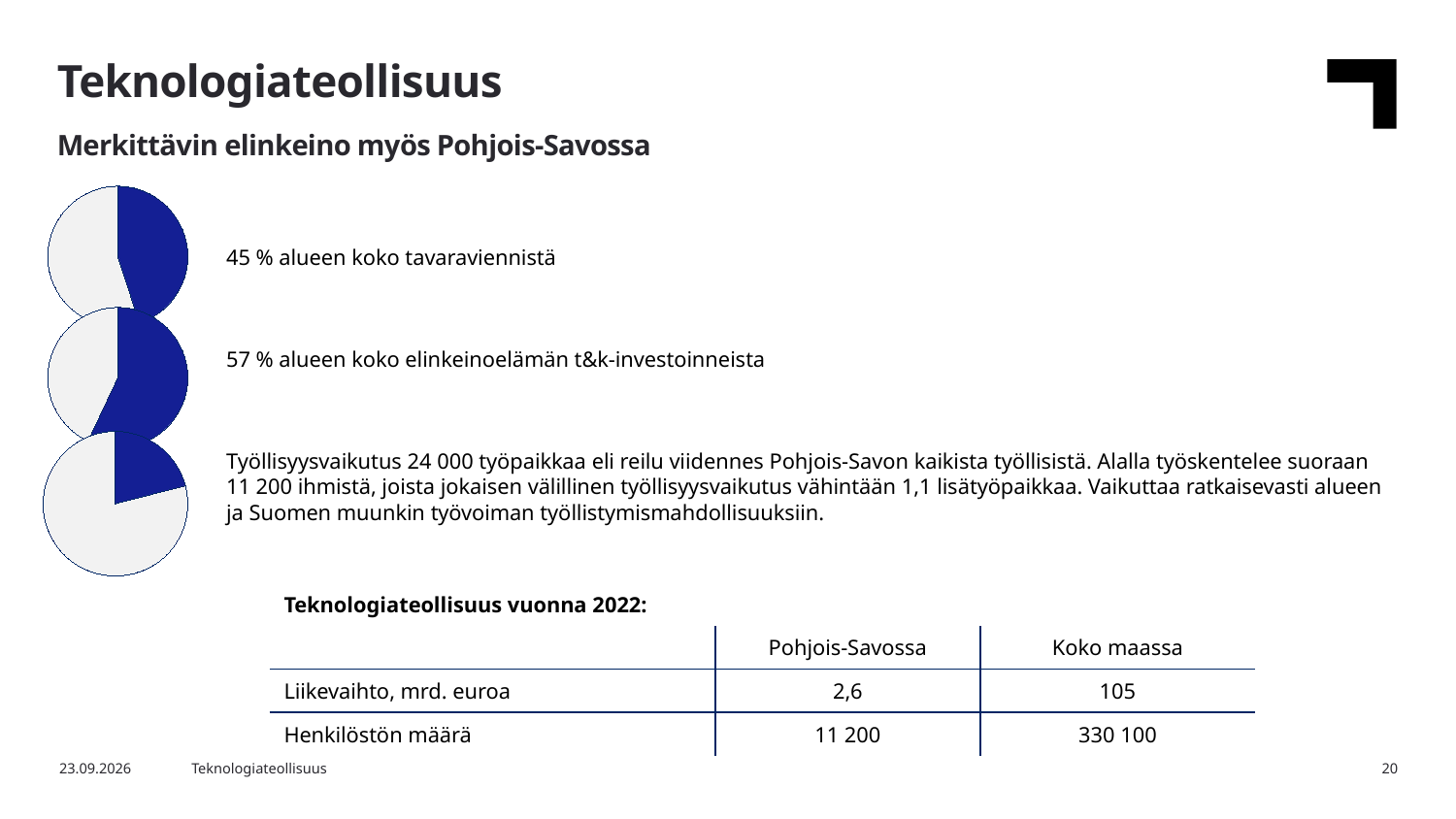
Which of the three pie charts has the largest highlighted (blue) slice? The middle pie chart (57 %) Which of the three pie charts has the smallest highlighted (blue) slice? The bottom pie chart In the middle pie chart, what share does the blue slice represent (share of the region's business R&D investments)? 57 % What kind of charts are shown on the left side of the slide? Pie charts What is the difference in percentage points between the blue slice of the middle pie chart (57 %) and the blue slice of the top pie chart (45 %)? 12 percentage points Which pie chart has the larger blue slice, the top one or the middle one? The middle one In the bottom pie chart, is the blue slice more or less than half of the pie? Less What does the top pie chart represent, according to the text next to it? 45 % alueen koko tavaraviennistä How many pie charts are on the slide? 3 In the top pie chart, what share does the blue slice represent (share of the region's total goods exports)? 45 % What colour is the highlighted slice in each pie chart? Blue How many slices does each pie chart have? 2